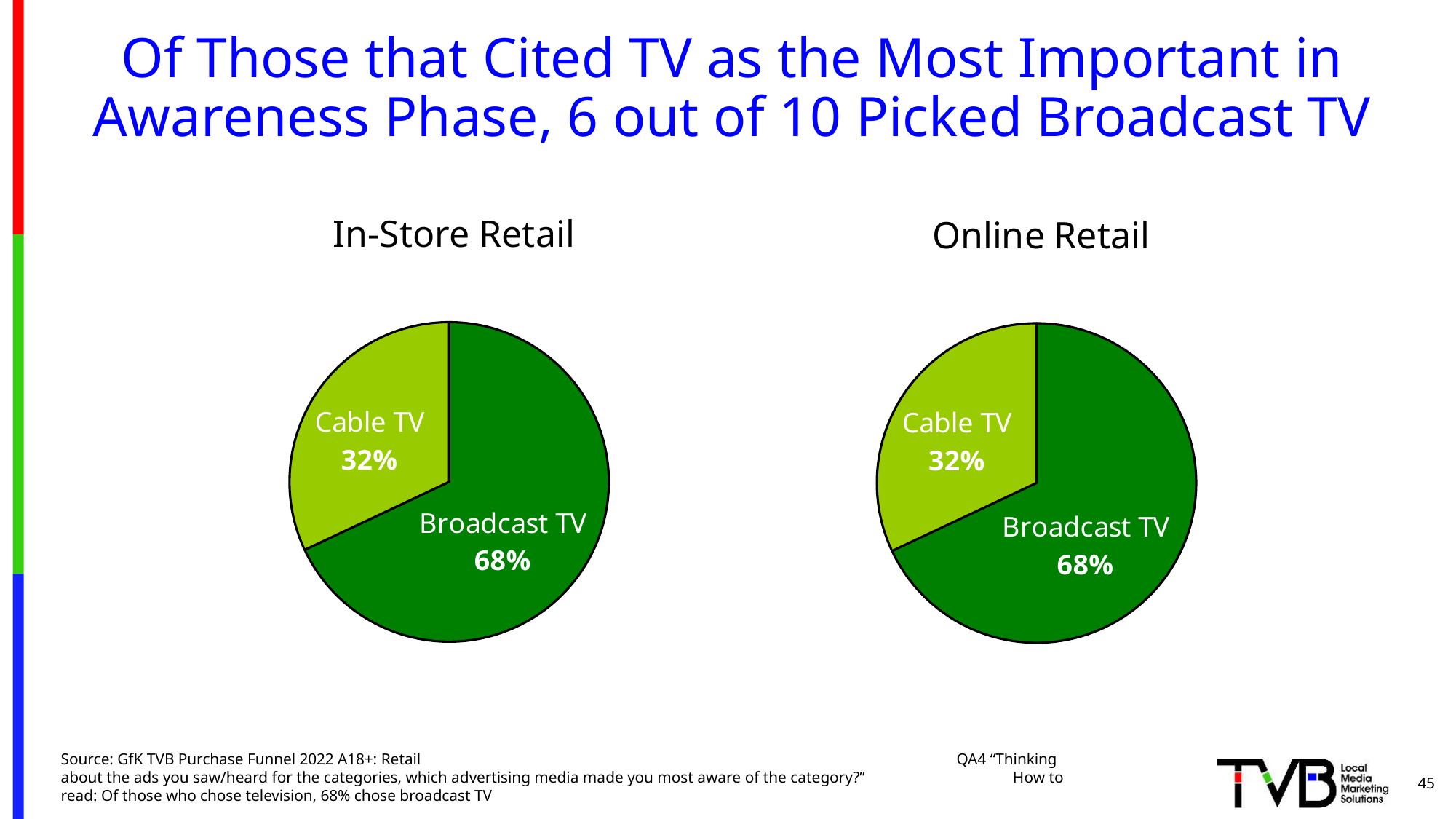
How many slices does the Online Retail pie chart have? 2 How many pie charts are shown on the slide? 2 In the In-Store Retail chart, which slice is the largest? Broadcast TV In the In-Store Retail chart, what is the difference in percentage points between Broadcast TV and Cable TV? 36 percentage points In the Online Retail chart, what share of the pie is Broadcast TV? 68% In the Online Retail chart, which slice is the smallest? Cable TV In the Online Retail chart, what share of the pie is Cable TV? 32% In the In-Store Retail chart, what share of the pie is Broadcast TV? 68% What kind of chart is the In-Store Retail chart? Pie chart In the Online Retail chart, which is larger, Cable TV or Broadcast TV? Broadcast TV What is the title of the chart on the right side of the slide? Online Retail